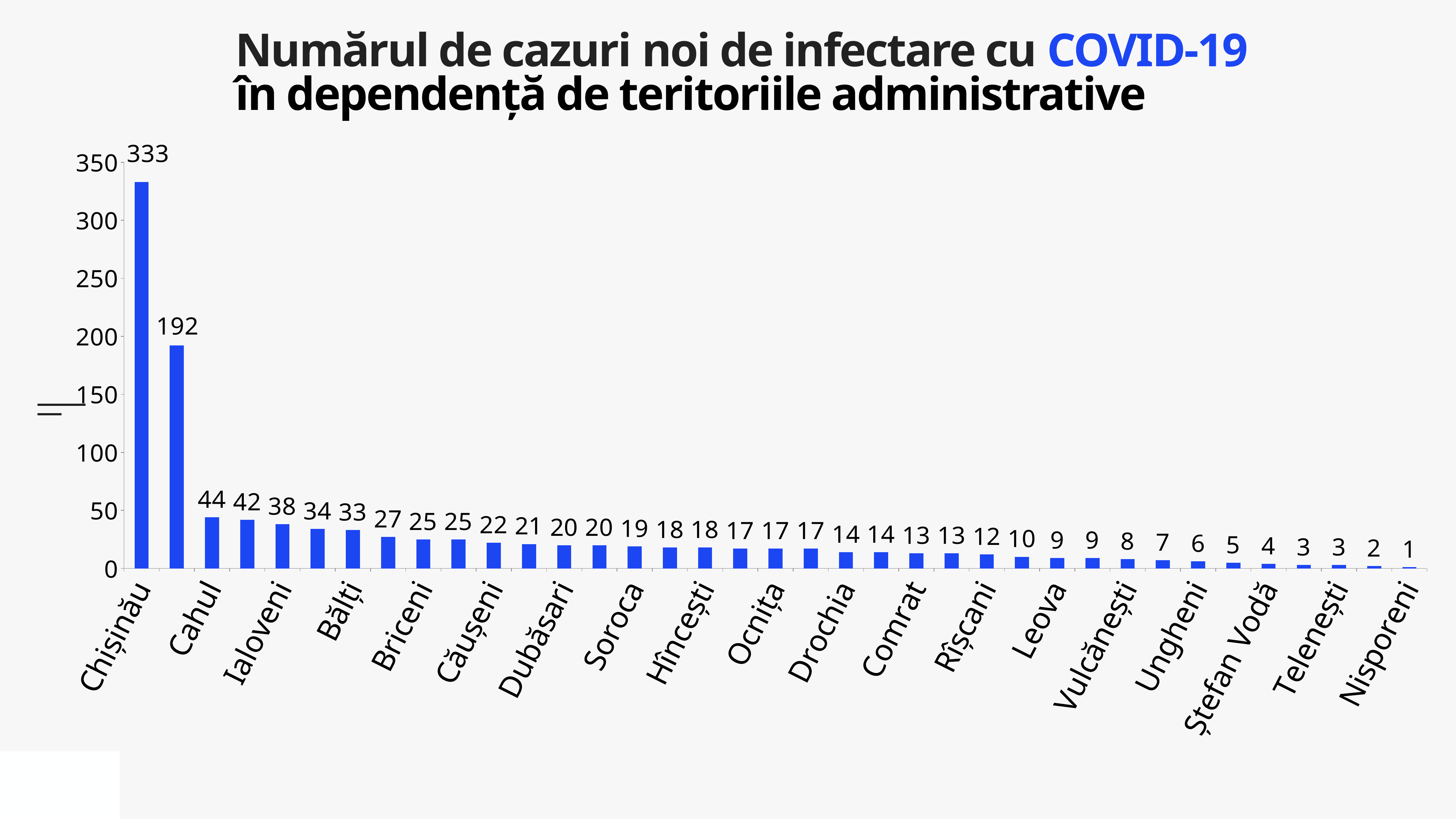
Is the value for Nisporeni greater or less than 50? less What is the highest value printed on the y axis? 350 Which is larger, the value for Chișinău or the value for Nisporeni? Chișinău What type of chart is shown on the slide? bar chart Is the value for Chișinău greater or less than 300? greater Which territory has the highest number of new cases? Chișinău What is the difference between the values for Chișinău and Nisporeni? 332 What colour are the bars in the chart? blue Which territory has the lowest number of new cases? Nisporeni What is the value for Nisporeni? 1 What is the value for Chișinău? 333 Do the values rise or fall from left to right along the x axis? fall